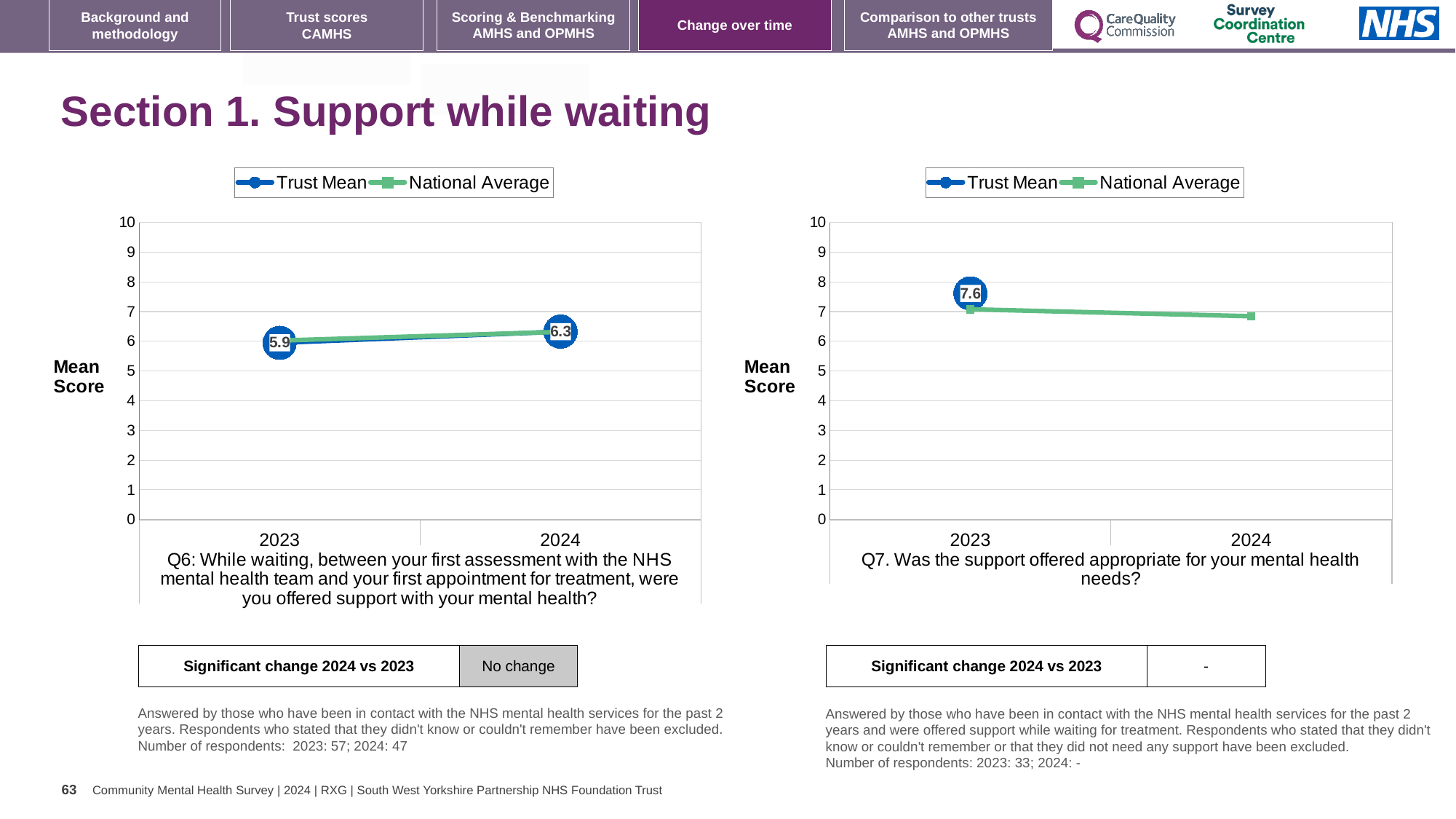
In the left chart (Q6), by how much did the Trust Mean change from 2023 to 2024? 0.4 In the right chart (Q7), what is the Trust Mean score for 2023? 7.6 In the left chart (Q6), what is the Trust Mean score for 2023? 5.9 In the right chart (Q7), is the National Average for 2024 greater or less than 7? less In the left chart (Q6), does the Trust Mean rise or fall from 2023 to 2024? rise What is the label on the y axis of the left chart (Q6)? Mean Score In the left chart (Q6), which year has the higher Trust Mean, 2023 or 2024? 2024 What kind of chart is the left chart (Q6)? line chart How many series does the legend of the right chart (Q7) list? 2 How many years are shown on the x axis of the left chart (Q6)? 2 In the right chart (Q7), does the National Average rise or fall from 2023 to 2024? fall In the left chart (Q6), what is the Trust Mean score for 2024? 6.3